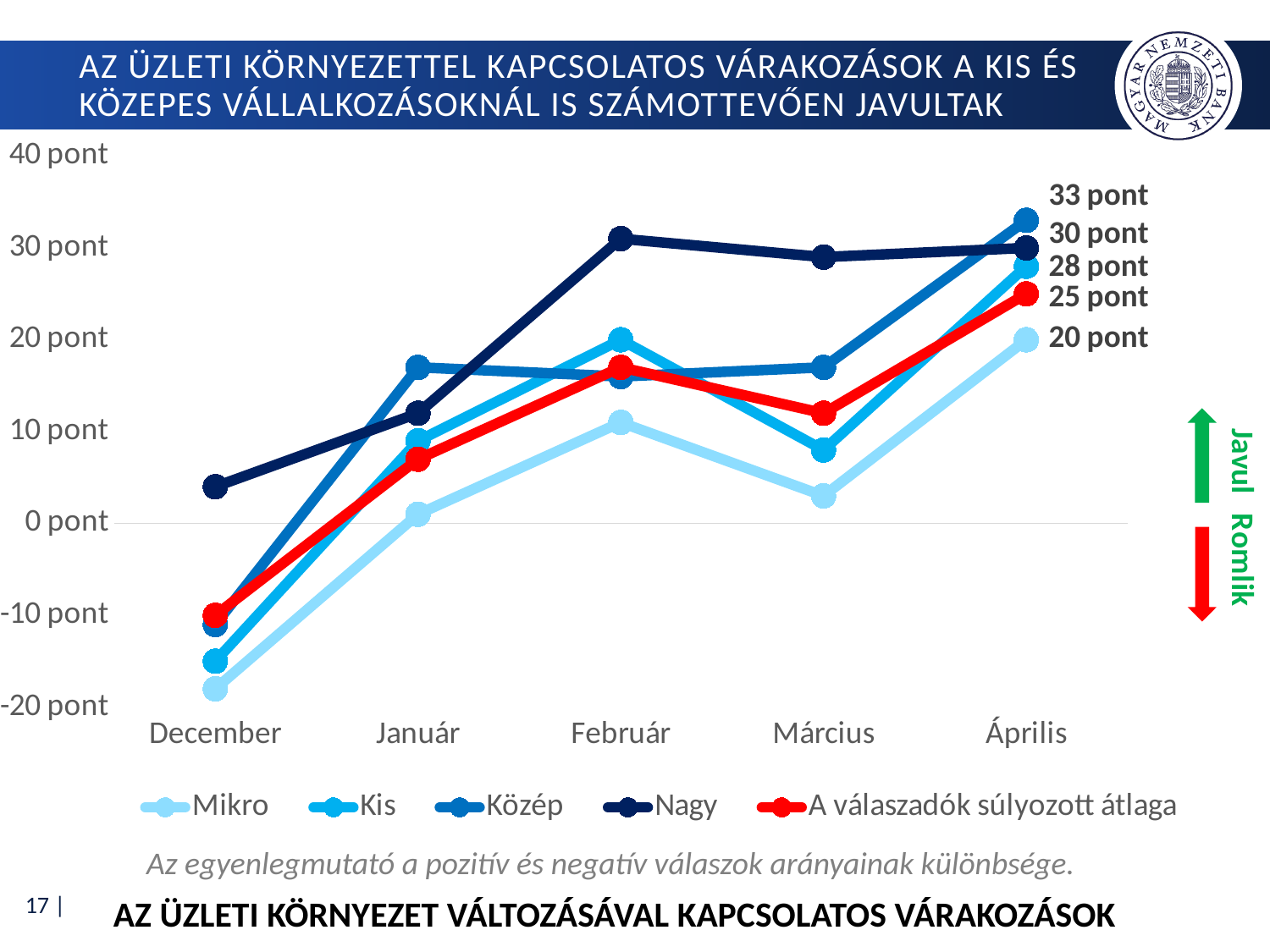
Which series has the highest value in Április? Közép What is the value for Mikro in Április? 20 pont What is the difference between the Közép and Mikro values in Április? 13 pont How many months are shown on the x axis? 5 Is the value for Nagy in Február greater or less than 20 pont? greater How many series does the legend list? 5 What kind of chart is shown on the slide? line chart Does the Mikro series rise or fall from Február to Március? fall Which series has the lowest value in Április? Mikro What is the value for Közép in Április? 33 pont Which is larger in December, the value for Nagy or the value for Mikro? Nagy What is the value for A válaszadók súlyozott átlaga in Április? 25 pont